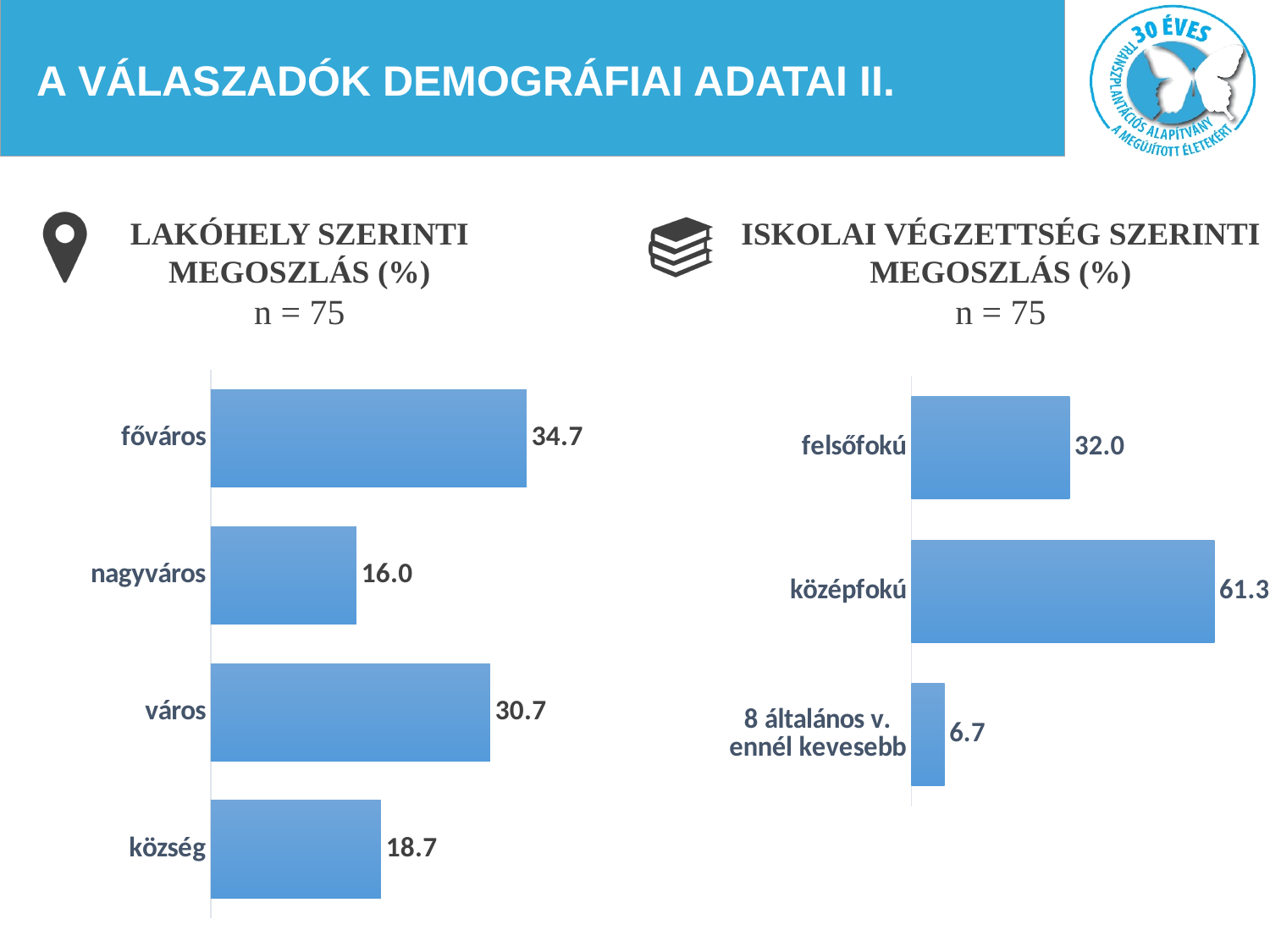
In the left chart (Lakóhely szerinti megoszlás), what is the value for nagyváros? 16.0 What type of chart is the right chart (Iskolai végzettség szerinti megoszlás)? bar chart In the left chart (Lakóhely szerinti megoszlás), how many categories are shown? 4 In the right chart (Iskolai végzettség szerinti megoszlás), which is larger, felsőfokú or 8 általános v. ennél kevesebb? felsőfokú In the right chart (Iskolai végzettség szerinti megoszlás), which category has the highest value? középfokú In the left chart (Lakóhely szerinti megoszlás), which category has the lowest value? nagyváros In the left chart (Lakóhely szerinti megoszlás), what is the difference between the values for város and község? 12.0 In the right chart (Iskolai végzettség szerinti megoszlás), what is the difference between középfokú and felsőfokú? 29.3 In the right chart (Iskolai végzettség szerinti megoszlás), what is the value for 8 általános v. ennél kevesebb? 6.7 In the left chart (Lakóhely szerinti megoszlás), which category has the highest value? főváros In the left chart (Lakóhely szerinti megoszlás), what is the value for főváros? 34.7 In the right chart (Iskolai végzettség szerinti megoszlás), what is the value for középfokú? 61.3